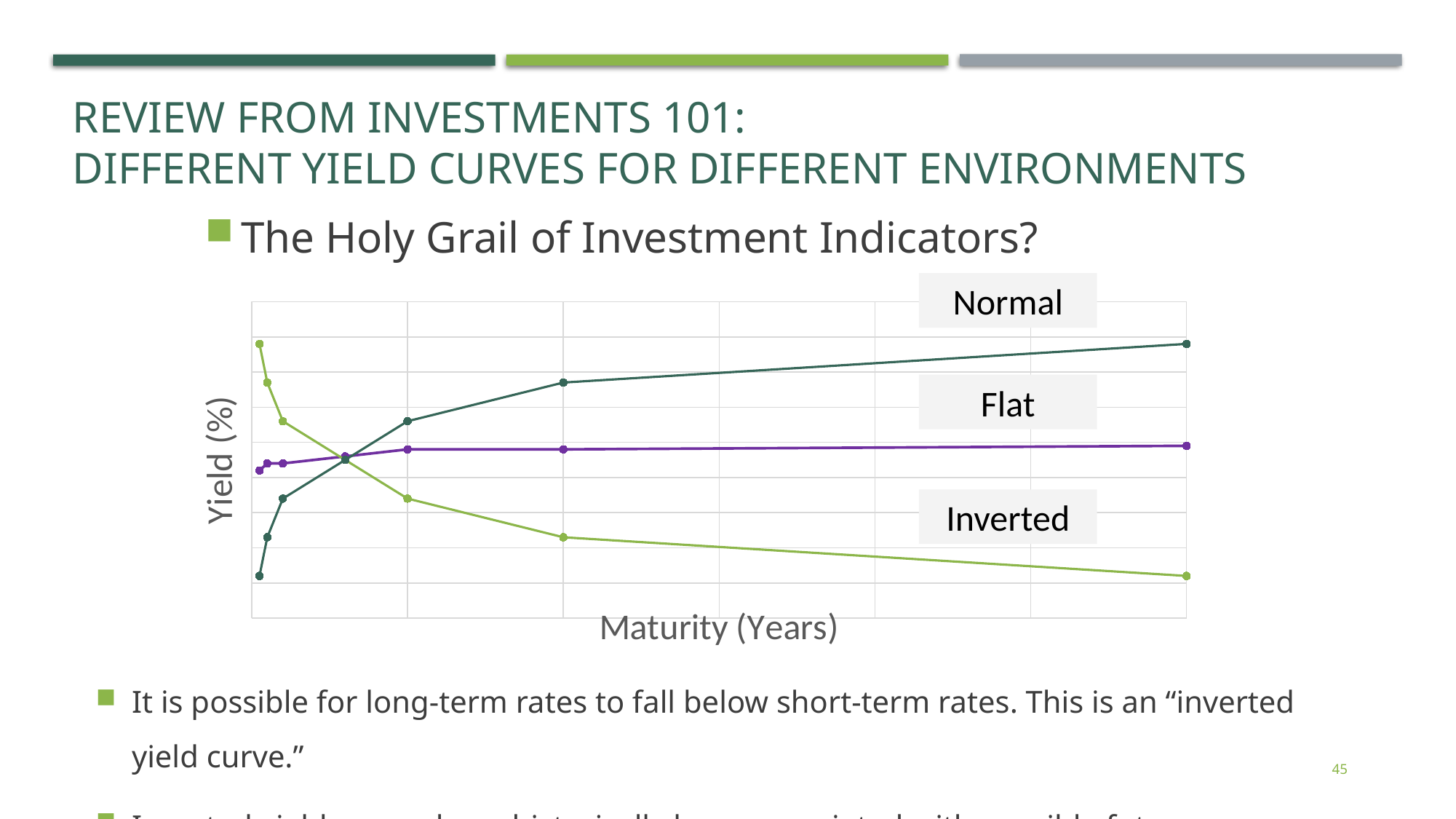
What are the names of the three curves labelled on the chart? Normal, Flat, Inverted What is the label of the vertical axis? Yield (%) How many series (curves) are labelled on the chart? 3 What is the label of the horizontal axis? Maturity (Years) At the longest maturity shown, which curve has the lowest yield? Inverted At the longest maturity shown, which curve has the higher yield, Flat or Inverted? Flat Does the Inverted curve rise or fall as maturity increases? fall Does the Flat curve change much as maturity increases, or stay roughly level? stay roughly level At the shortest maturity shown, which curve has the higher yield, Normal or Inverted? Inverted What kind of chart is shown on the slide? line chart At the longest maturity shown, which curve has the highest yield? Normal Does the Normal curve rise or fall as maturity increases? rise